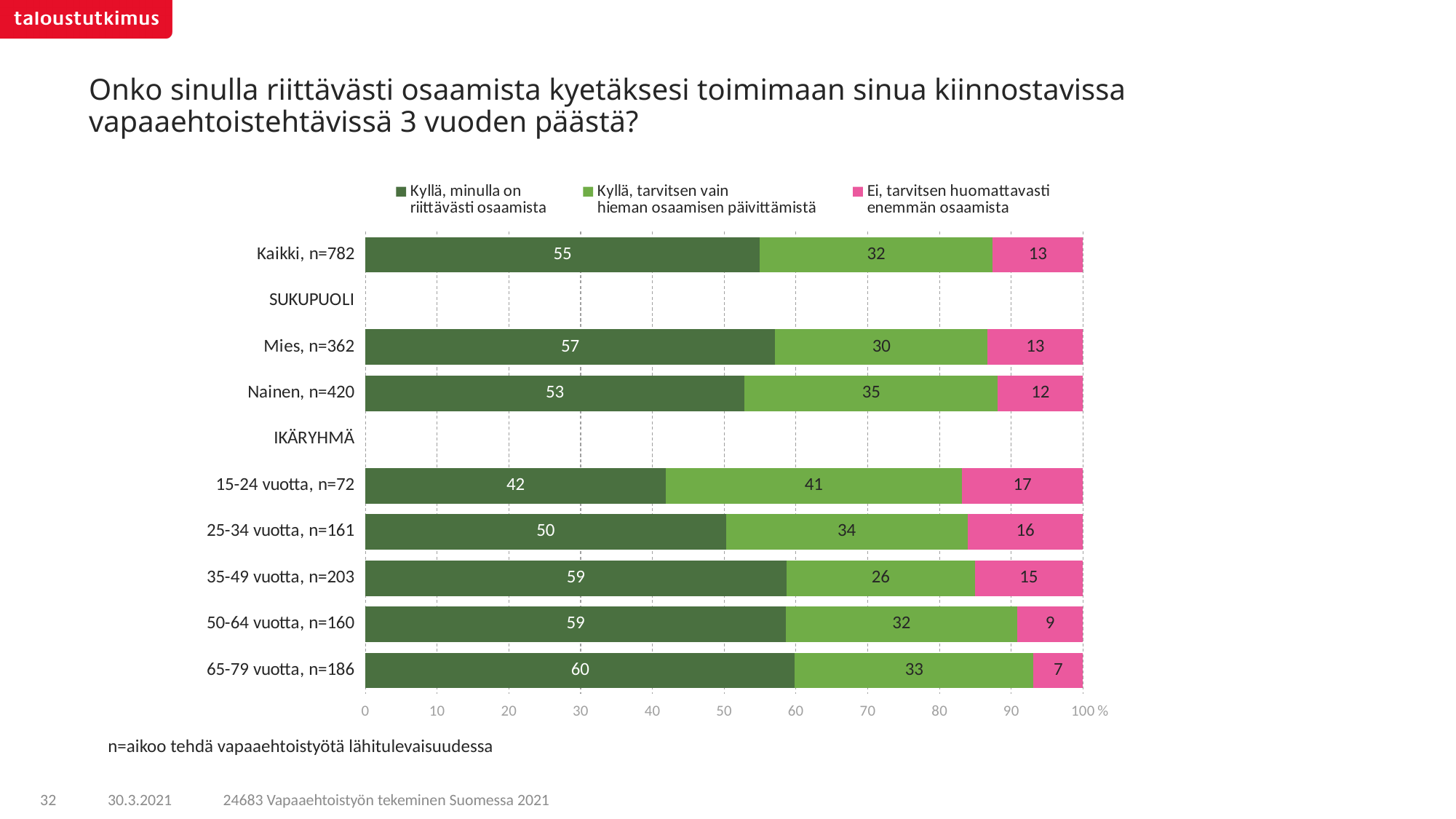
What is the value of "Kyllä, tarvitsen vain hieman osaamisen päivittämistä" for Nainen, n=420? 35 How many series does the legend list? 3 Which group has the highest value for "Kyllä, minulla on riittävästi osaamista"? 65-79 vuotta, n=186 Which group has the lowest value for "Ei, tarvitsen huomattavasti enemmän osaamista"? 65-79 vuotta, n=186 How many groups have bars plotted in the chart? 8 Which group has the lowest value for "Kyllä, minulla on riittävästi osaamista"? 15-24 vuotta, n=72 Which is larger: the "Kyllä, tarvitsen vain hieman osaamisen päivittämistä" value for 25-34 vuotta, n=161 or for 35-49 vuotta, n=203? 25-34 vuotta, n=161 What kind of chart is shown on the slide? Stacked bar chart What is the value of "Kyllä, minulla on riittävästi osaamista" for Kaikki, n=782? 55 What is the total of the stacked bar for 50-64 vuotta, n=160? 100 What is the difference between the "Kyllä, minulla on riittävästi osaamista" values for Mies, n=362 and Nainen, n=420? 4 What is the value of "Ei, tarvitsen huomattavasti enemmän osaamista" for 15-24 vuotta, n=72? 17